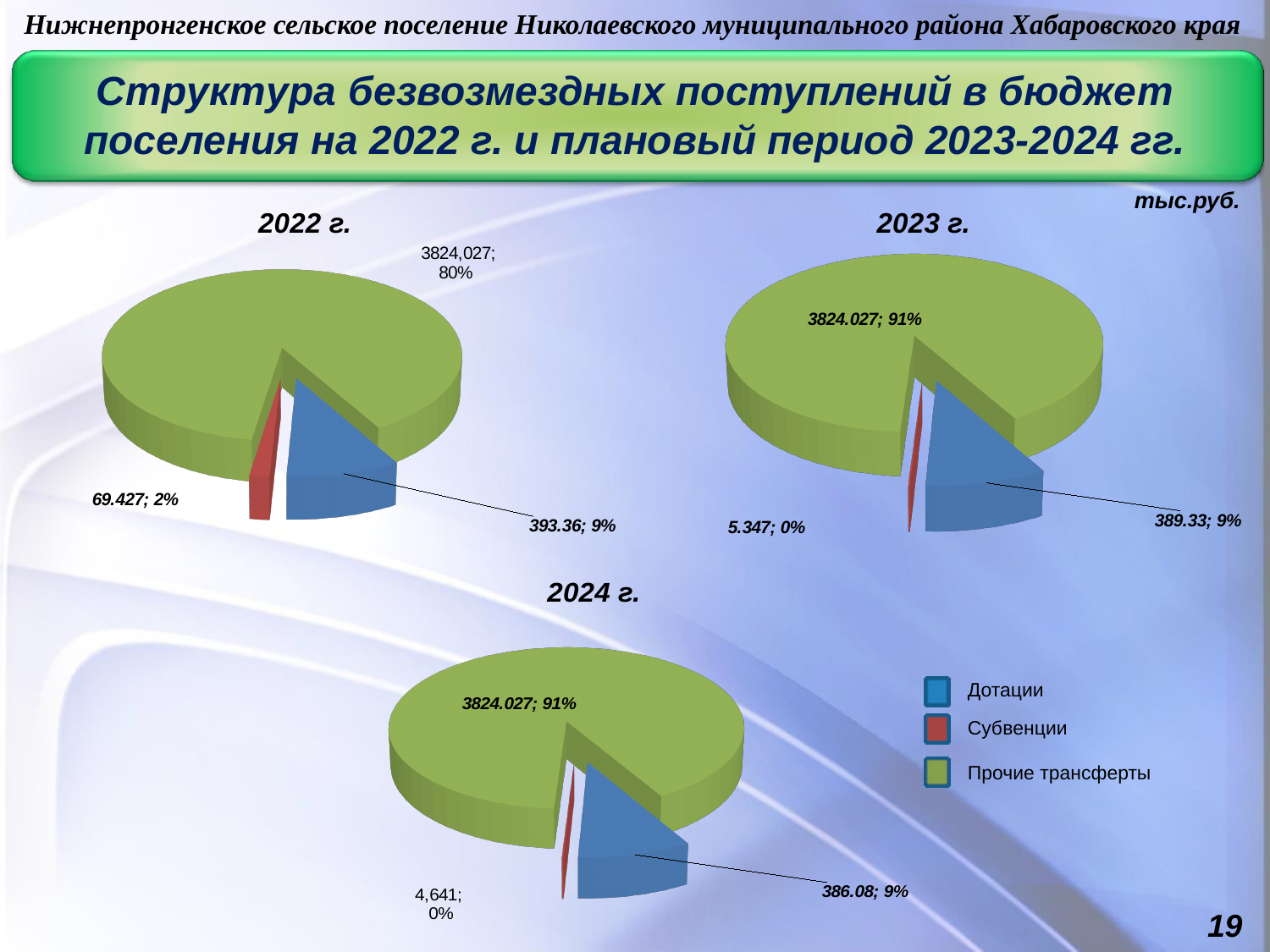
Which colour represents Дотации in the legend? blue In the 2022 г. chart, what value and share are shown for Прочие трансферты? 3824,027; 80% What kind of chart is used for the 2022 г. chart? pie chart In the 2022 г. chart, what value is shown for Субвенции? 69.427 In the 2023 г. chart, what value is shown for Дотации? 389.33 How many categories does the legend list? 3 In the 2022 г. chart, what share of the pie is Дотации? 9% In the 2024 г. chart, which category has the largest slice? Прочие трансферты In the 2023 г. chart, which category has the smallest slice? Субвенции In the 2023 г. chart, what share of the pie is Прочие трансферты? 91% In the 2024 г. chart, what value is shown for Дотации? 386.08 In the 2024 г. chart, what value is shown for Субвенции? 4,641